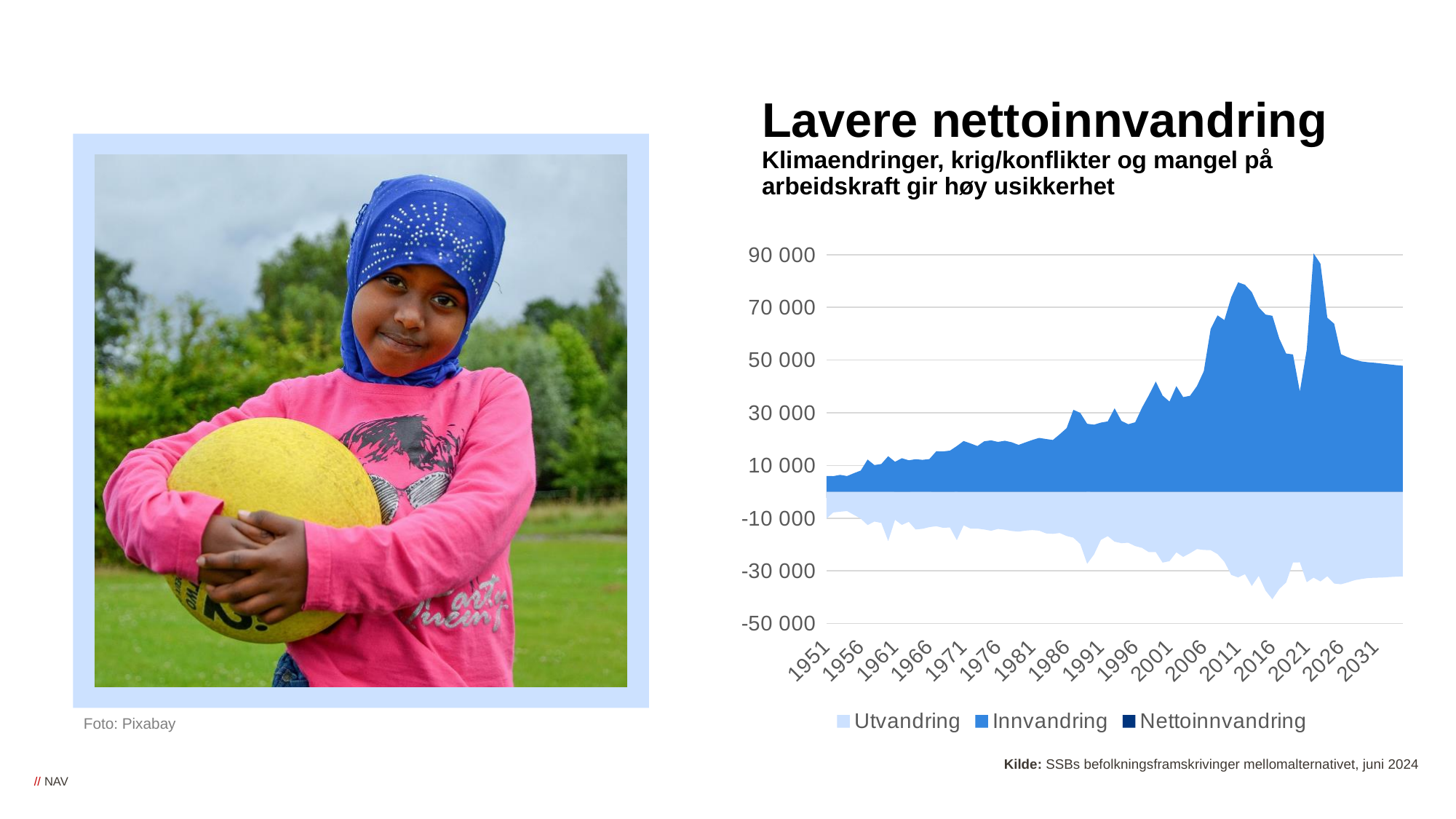
Is the value for Innvandring in 1951 greater or less than 10 000? less How many year labels are shown on the x axis? 17 How many series does the chart legend list? 3 Which is larger, the Innvandring value in 2011 or in 1951? 2011 Is the value for Utvandring around 2016 greater or less than -30 000? less Is the value for Innvandring in 2031 greater or less than 30 000? greater What are the three series listed in the chart legend? Utvandring, Innvandring, Nettoinnvandring What kind of chart is shown on the slide? area chart Does the Innvandring series generally rise or fall from 1951 to 2011? rise What is the title of the slide above the chart? Lavere nettoinnvandring